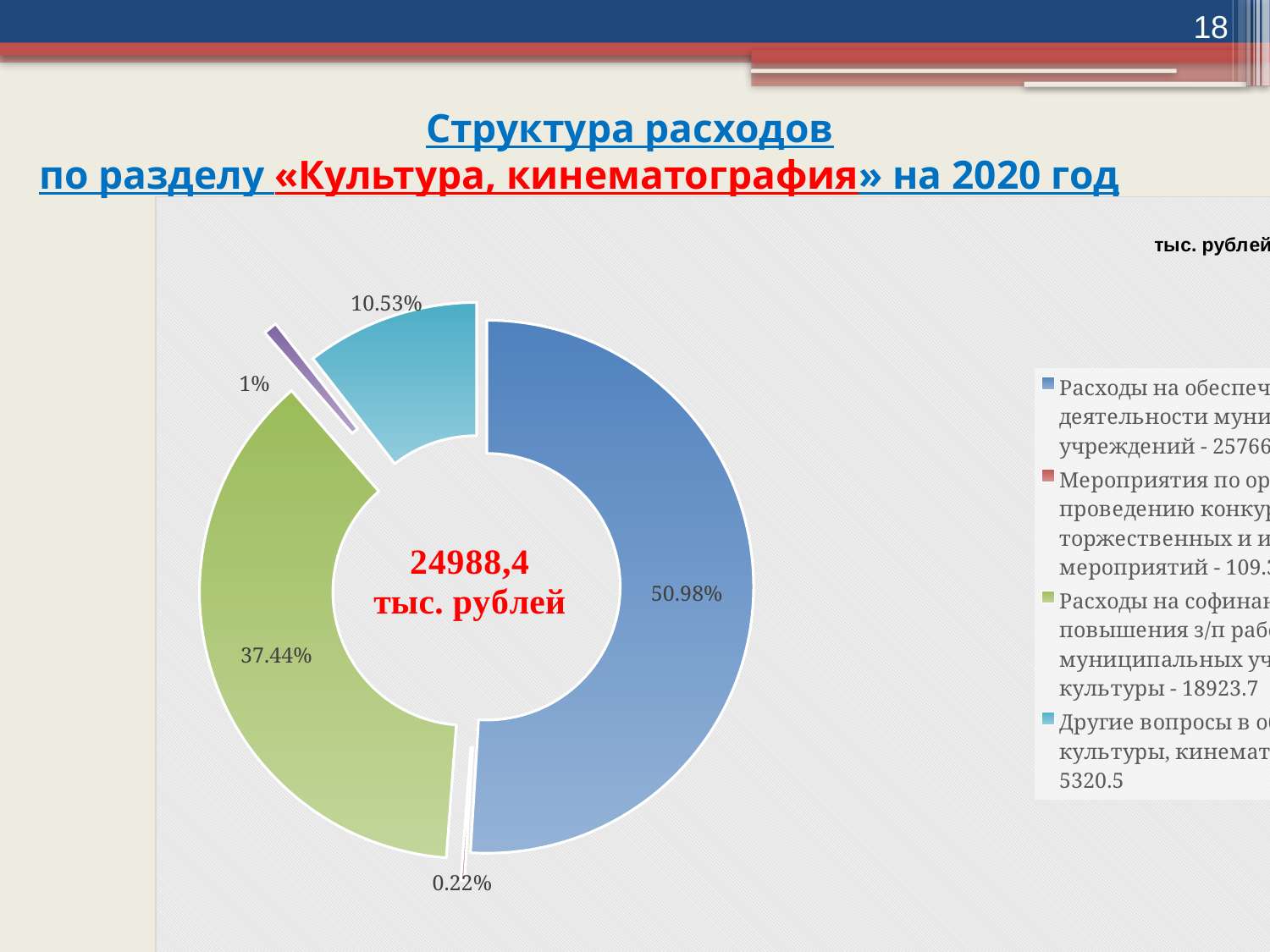
What is the difference in percentage points between the blue slice (50.98%) and the green slice (37.44%)? 13.54 percentage points Which slice is larger, the green one or the light blue one? the green one (37.44%) What is the share of the largest slice of the doughnut chart? 50.98% What total is written in the centre of the doughnut chart? 24988,4 тыс. рублей What share is labelled on the green slice of the doughnut chart? 37.44% What is the share of the smallest slice of the doughnut chart? 0.22% What value is listed in the legend for the light blue entry 'Другие вопросы в области культуры, кинематографии'? 5320.5 What unit label is shown at the top right of the chart area? тыс. рублей What share is labelled on the light blue (cyan) slice of the doughnut chart? 10.53% What kind of chart is shown on the slide? doughnut (pie) chart How many slices does the doughnut chart have? 5 What share is labelled on the small purple slice of the doughnut chart? 1%